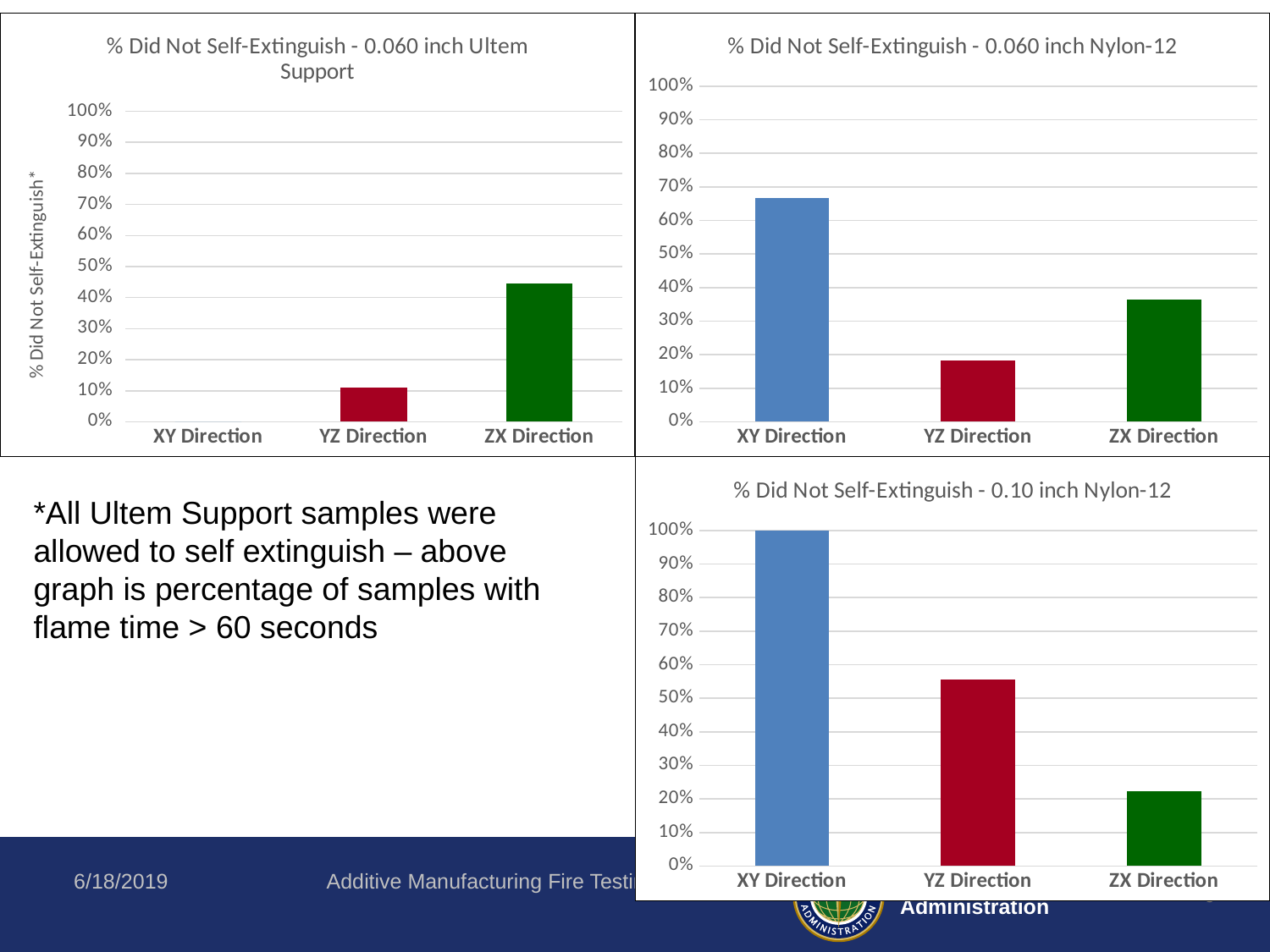
In the '% Did Not Self-Extinguish - 0.060 inch Ultem Support' chart, is the value for YZ Direction greater or less than 20%? less In the '% Did Not Self-Extinguish - 0.060 inch Nylon-12' chart, which direction has the lowest value? YZ Direction In the '% Did Not Self-Extinguish - 0.060 inch Ultem Support' chart, is the value for ZX Direction greater or less than 40%? greater In the '% Did Not Self-Extinguish - 0.10 inch Nylon-12' chart, what is the value for XY Direction? 100% What type of chart is the '% Did Not Self-Extinguish - 0.060 inch Nylon-12' chart? bar chart How many categories are shown in the '% Did Not Self-Extinguish - 0.10 inch Nylon-12' chart? 3 In the '% Did Not Self-Extinguish - 0.10 inch Nylon-12' chart, which is larger, YZ Direction or ZX Direction? YZ Direction In the '% Did Not Self-Extinguish - 0.10 inch Nylon-12' chart, do the values rise or fall from XY Direction to ZX Direction? fall In the '% Did Not Self-Extinguish - 0.060 inch Nylon-12' chart, is the value for XY Direction greater or less than 60%? greater In the '% Did Not Self-Extinguish - 0.060 inch Ultem Support' chart, what is the value for XY Direction? 0% In the '% Did Not Self-Extinguish - 0.060 inch Nylon-12' chart, which direction has the highest value? XY Direction In the '% Did Not Self-Extinguish - 0.060 inch Ultem Support' chart, which direction has the highest value? ZX Direction